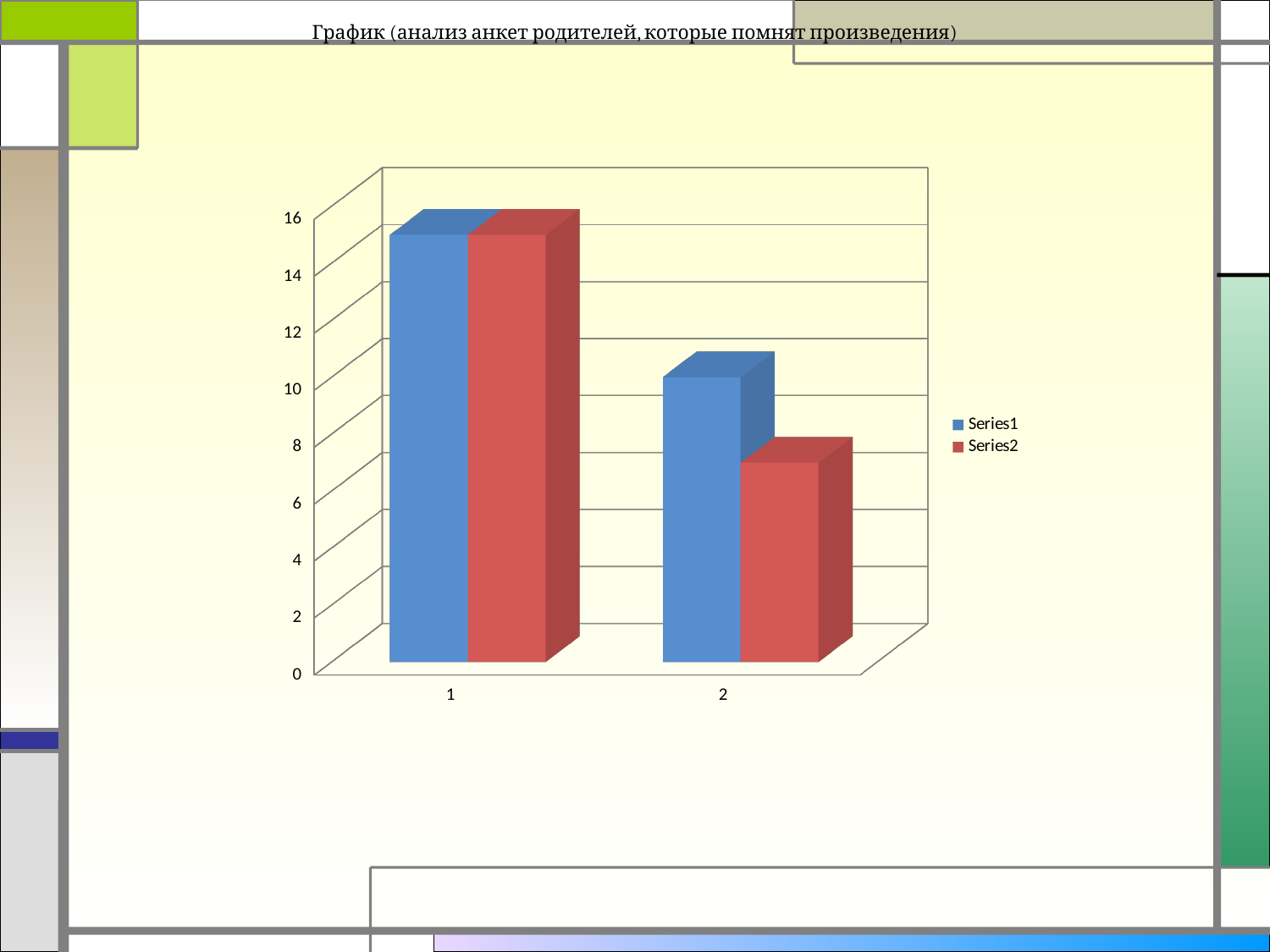
Is the value for Series2 in category 2 greater or less than 8? less What colour are the Series2 bars? red For Series1, which category has the higher value, 1 or 2? 1 How many categories are shown on the x axis? 2 Is the value for Series2 in category 1 greater or less than 12? greater For Series2, which category has the lower value, 1 or 2? 2 Is the value for Series1 in category 2 greater or less than 8? greater What kind of chart is shown on the slide? bar chart For category 2, which series has the larger value, Series1 or Series2? Series1 How many series does the legend list? 2 Do the values for Series2 rise or fall from category 1 to category 2? fall